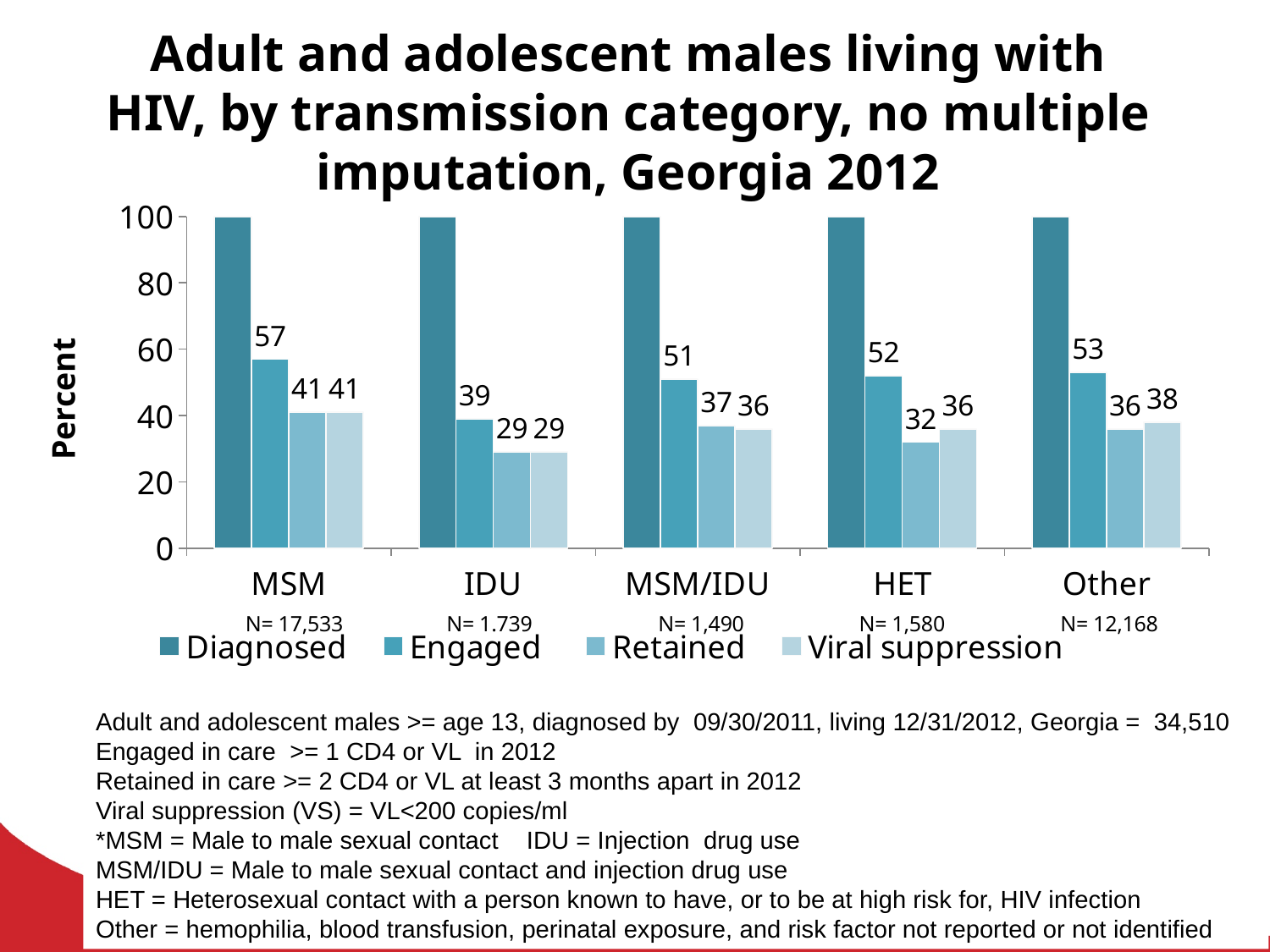
What kind of chart is shown on the slide? bar chart What is the Engaged value for IDU? 39 Which transmission category has the highest Engaged value? MSM How many series does the legend list? 4 Which transmission category has the lowest Retained value? IDU What is the Engaged value for MSM? 57 What is the Viral suppression value for Other? 38 How many transmission categories are shown on the x axis? 5 What is the Retained value for HET? 32 What is the difference between the Engaged values for MSM and IDU? 18 Is the Diagnosed value for MSM/IDU greater or less than 80? greater Which is larger, the Viral suppression value for HET or for Other? Other